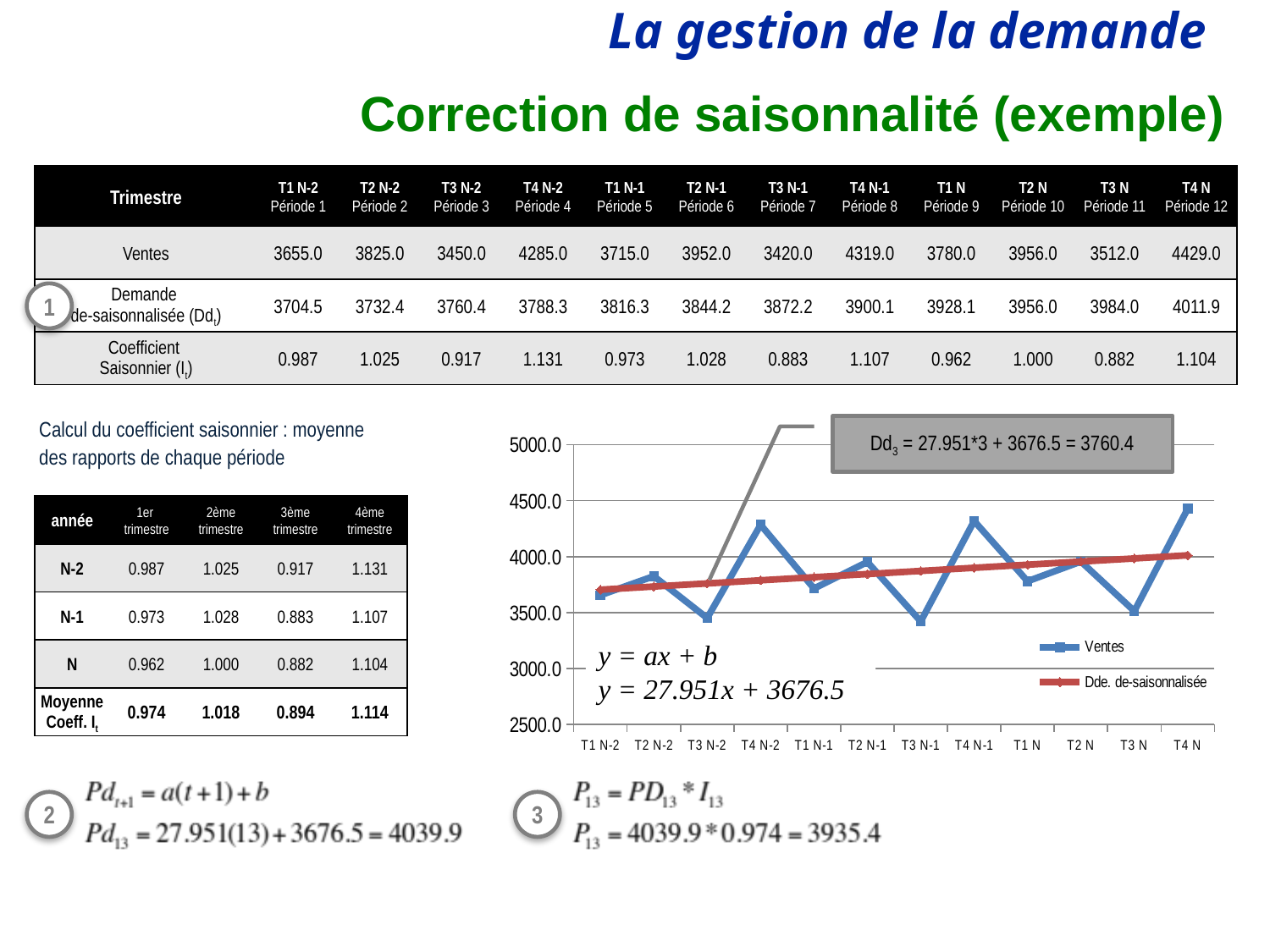
What is the Ventes value at T1 N-2? 3655.0 At which period does the Ventes series reach its highest value? T4 N What kind of chart is shown on the slide? line chart How many periods are plotted along the x axis of the chart? 12 Which is larger, the Ventes value at T2 N-2 or at T3 N-2? T2 N-2 Does the Dde. de-saisonnalisée series rise or fall from T1 N-2 to T4 N? rise Is the Ventes value at T4 N greater or less than 4000? greater Is the Ventes value at T3 N-1 greater or less than 3500? less What trend-line equation is printed on the chart? y = 27.951x + 3676.5 What is the difference between the Ventes value at T4 N and at T1 N-2? 774.0 At which period is the Dde. de-saisonnalisée series at its lowest? T1 N-2 How many series does the chart's legend list? 2